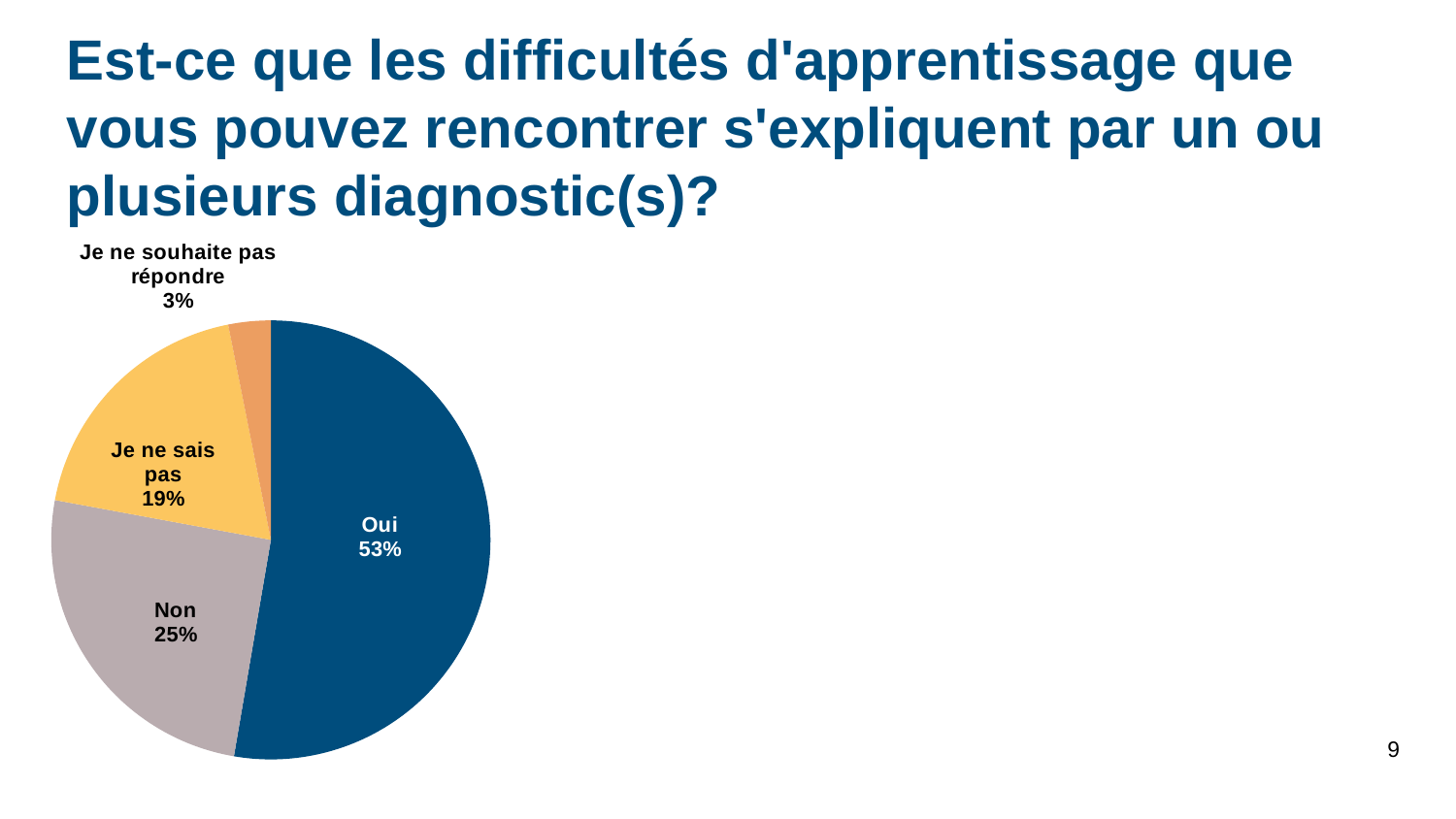
What is the difference in percentage points between "Oui" and "Non"? 28 What is the value shown for "Je ne souhaite pas répondre"? 3% What is the value shown for "Non"? 25% What colour is the "Oui" slice of the pie? dark blue What is the difference in percentage points between "Non" and "Je ne sais pas"? 6 What share of the pie does "Oui" represent? 53% Which category has the largest slice of the pie? Oui What is the value shown for "Je ne sais pas"? 19% Which category has the smallest slice of the pie? Je ne souhaite pas répondre How many categories are shown in the pie chart? 4 Which is larger, the slice for "Non" or the slice for "Je ne sais pas"? Non What kind of chart is shown on the slide? pie chart